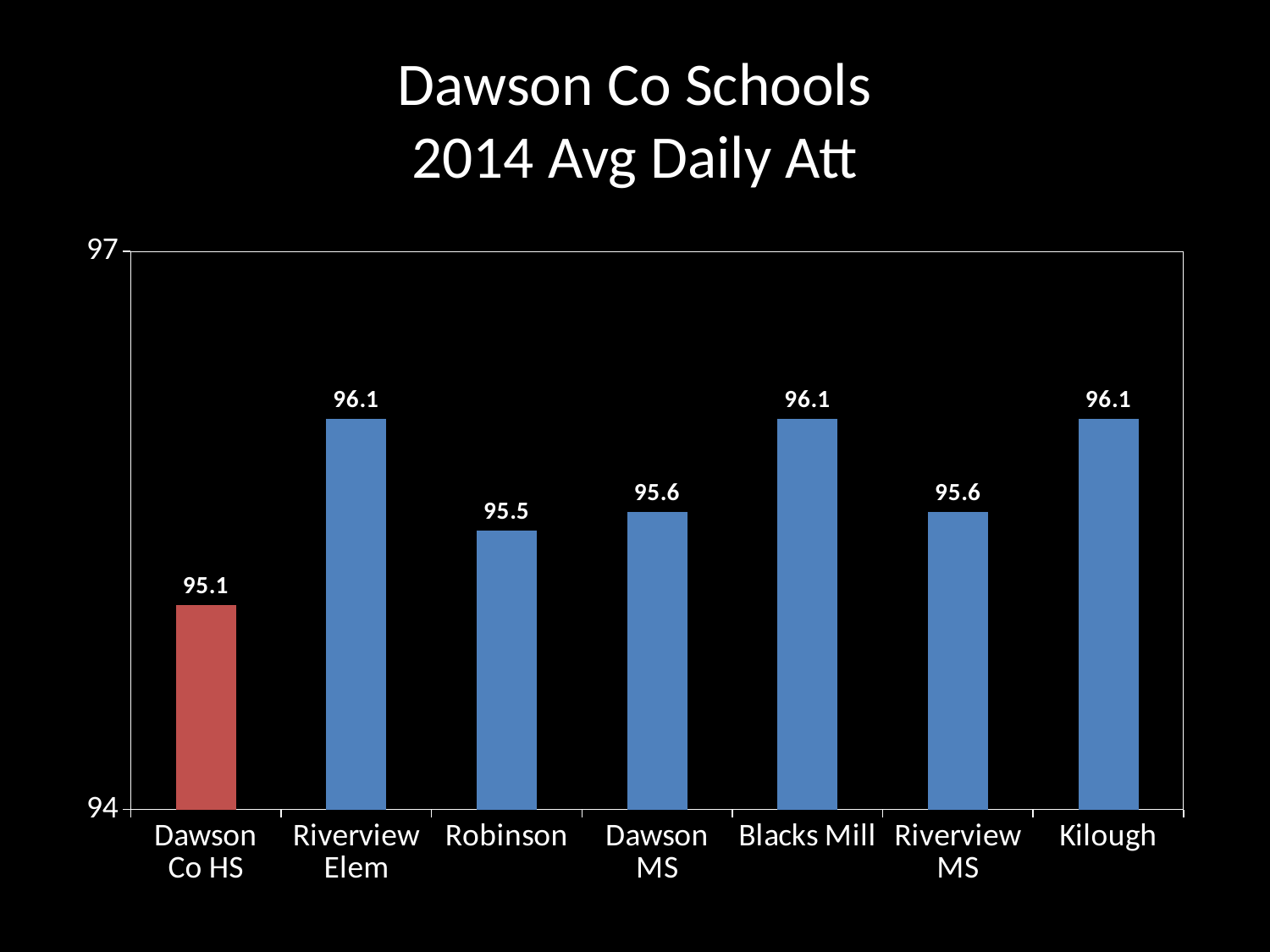
Which school has the lowest average daily attendance? Dawson Co HS How many schools are shown on the chart? 7 What is the value shown for Riverview MS? 95.6 What is the value shown for Kilough? 96.1 What is the difference between the values for Dawson MS and Robinson? 0.1 What is the title of the chart? Dawson Co Schools 2014 Avg Daily Att What is the difference between the values for Riverview Elem and Dawson Co HS? 1.0 Which school's bar is coloured red rather than blue? Dawson Co HS What is the value shown for Robinson? 95.5 Which is larger, the value for Blacks Mill or the value for Riverview MS? Blacks Mill What is the 2014 average daily attendance for Dawson Co HS? 95.1 What kind of chart is shown on the slide? Bar chart